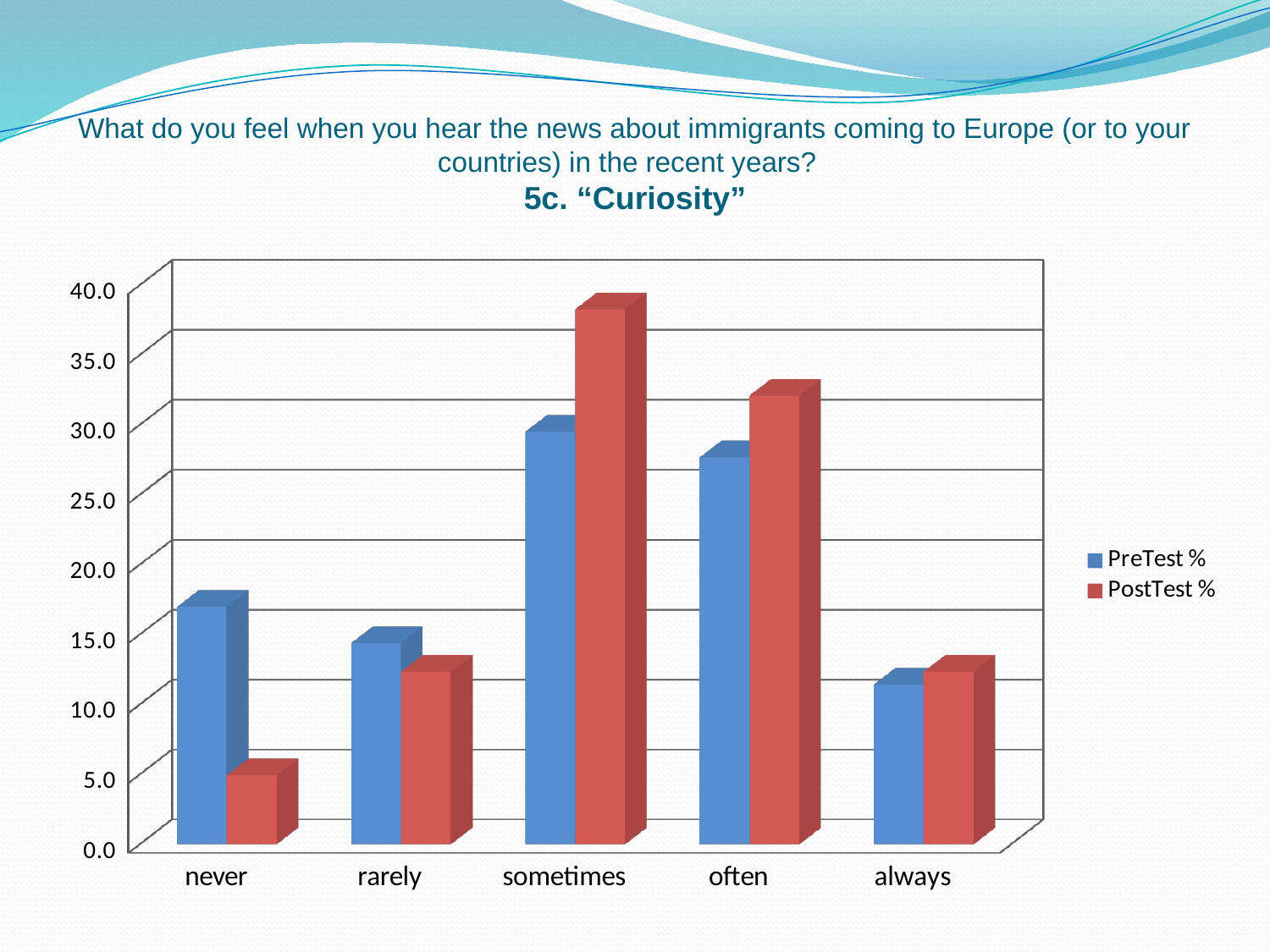
What kind of chart is shown on the slide? bar chart Is the PostTest % value for 'sometimes' greater or less than 35.0? greater How many categories are shown on the x axis of the chart? 5 Which category has the highest PostTest % value? sometimes What are the two series names listed in the chart's legend? PreTest % and PostTest % Which category has the highest PreTest % value? sometimes Which category has the lowest PreTest % value? always How many series does the chart's legend list? 2 For the category 'never', which is larger: PreTest % or PostTest %? PreTest % Is the PostTest % value for 'never' greater or less than 10.0? less Which category has the lowest PostTest % value? never For the category 'sometimes', which is larger: PreTest % or PostTest %? PostTest %